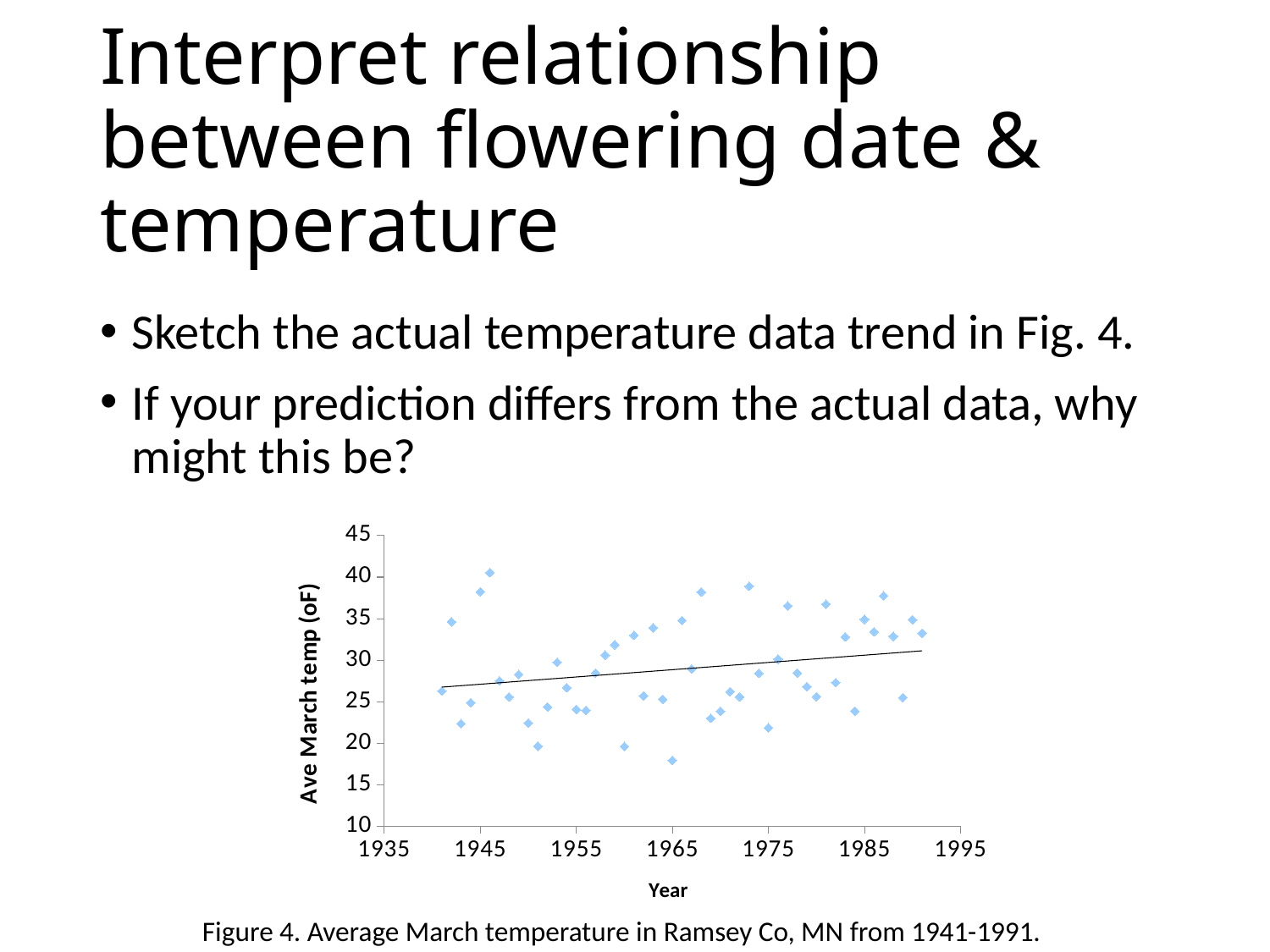
Does the fitted trend line in Figure 4 rise or fall as the year increases? rises According to the caption, which location does the temperature data in Figure 4 come from? Ramsey Co, MN What is the label of the vertical axis in Figure 4? Ave March temp (oF) Is the lowest plotted temperature in Figure 4 greater or less than 15? greater Is the highest plotted temperature in Figure 4 greater or less than 35? greater Is the highest plotted temperature in Figure 4 greater or less than 45? less In Figure 4, is the trend line higher at 1941 or at 1991? 1991 What kind of chart is shown in Figure 4? scatter plot